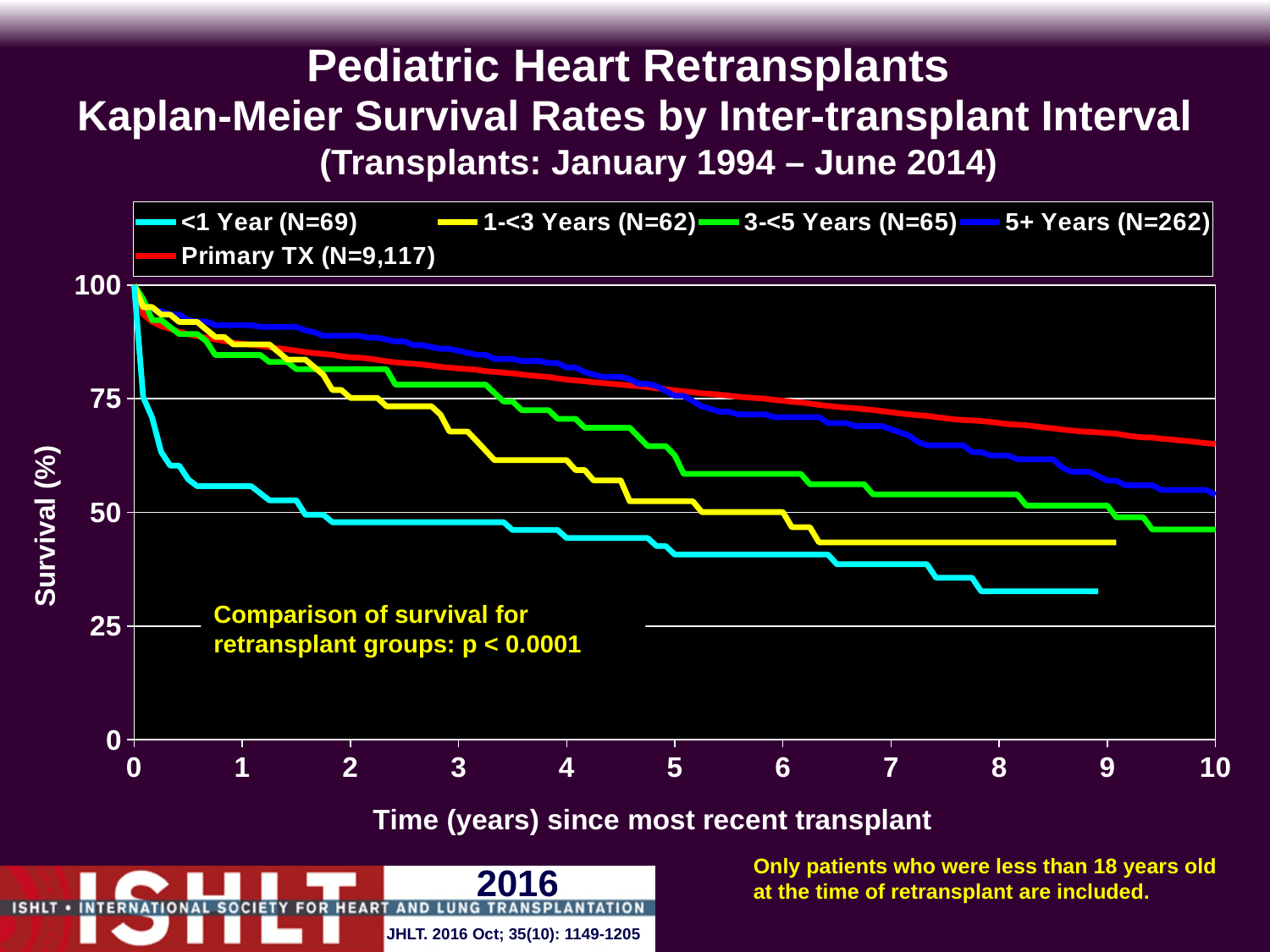
Is the survival for the <1 Year group at 5 years greater or less than 50%? less What p-value is reported for the comparison of survival for retransplant groups? p < 0.0001 Is the survival for the Primary TX group at 10 years greater or less than 75%? less At 5 years, which group has higher survival: <1 Year or 3-<5 Years? 3-<5 Years What kind of chart is shown on the slide? Line chart Which group has the lowest survival at 5 years since most recent transplant? <1 Year (N=69) How many patients (N) are in the 5+ Years group according to the legend? 262 How many series does the legend list? 5 Is the survival for the 1-<3 Years group at 9 years greater or less than 50%? less Do the survival curves rise or fall as time since transplant increases? Fall Which group has the highest survival at 10 years since most recent transplant? Primary TX (N=9,117)